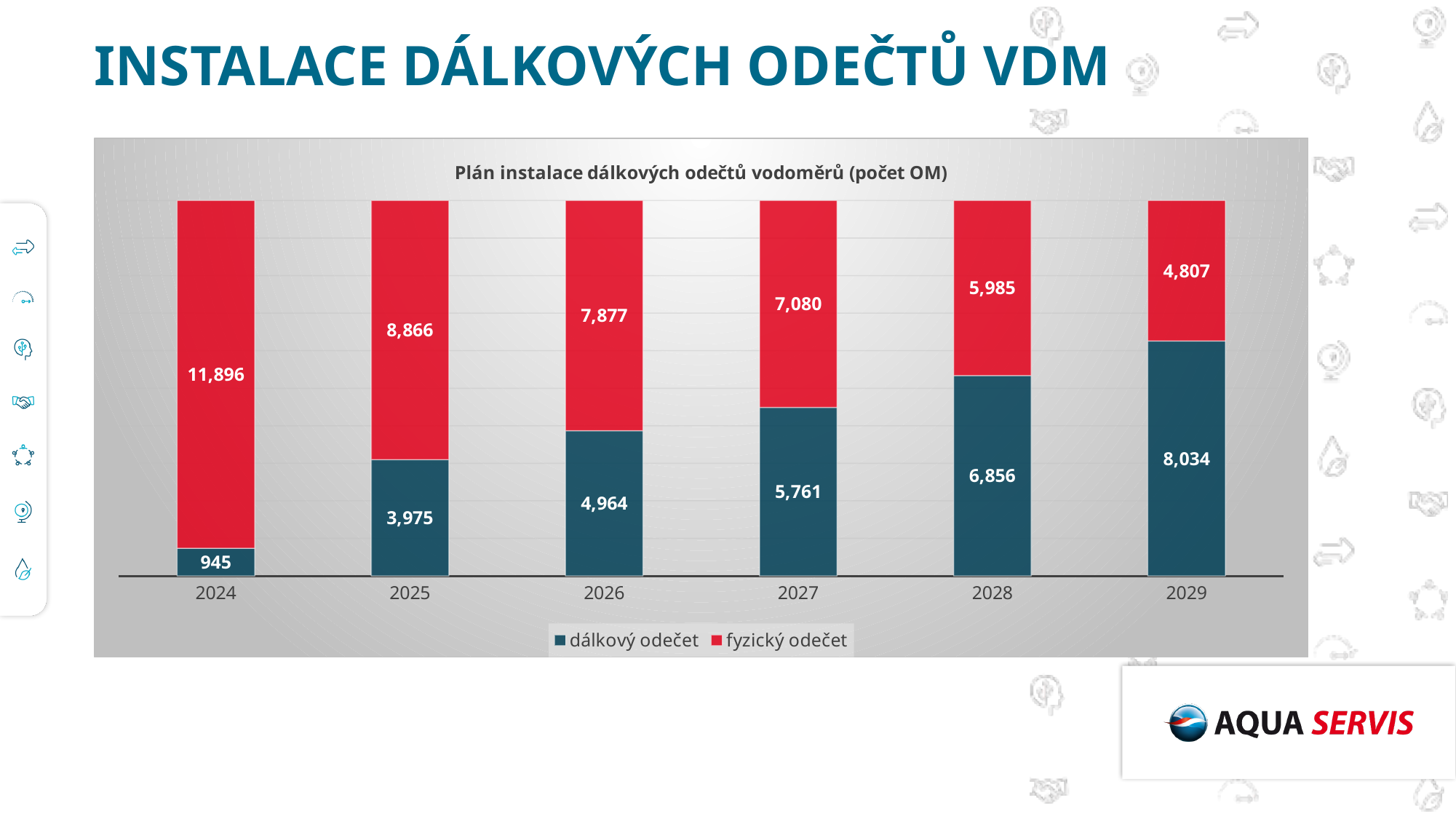
How many years are shown on the x axis? 6 What kind of chart is shown on the slide? Stacked bar chart What is the value for fyzický odečet in 2029? 4,807 What is the value for dálkový odečet in 2027? 5,761 Which year has the lowest value for fyzický odečet? 2029 Which year has the highest value for dálkový odečet? 2029 How many series does the legend list? 2 What is the value for fyzický odečet in 2025? 8,866 What is the value for dálkový odečet in 2024? 945 What is the total of the stacked bar for 2024? 12,841 What is the difference between fyzický odečet and dálkový odečet in 2026? 2,913 In 2028, which is larger: dálkový odečet or fyzický odečet? dálkový odečet